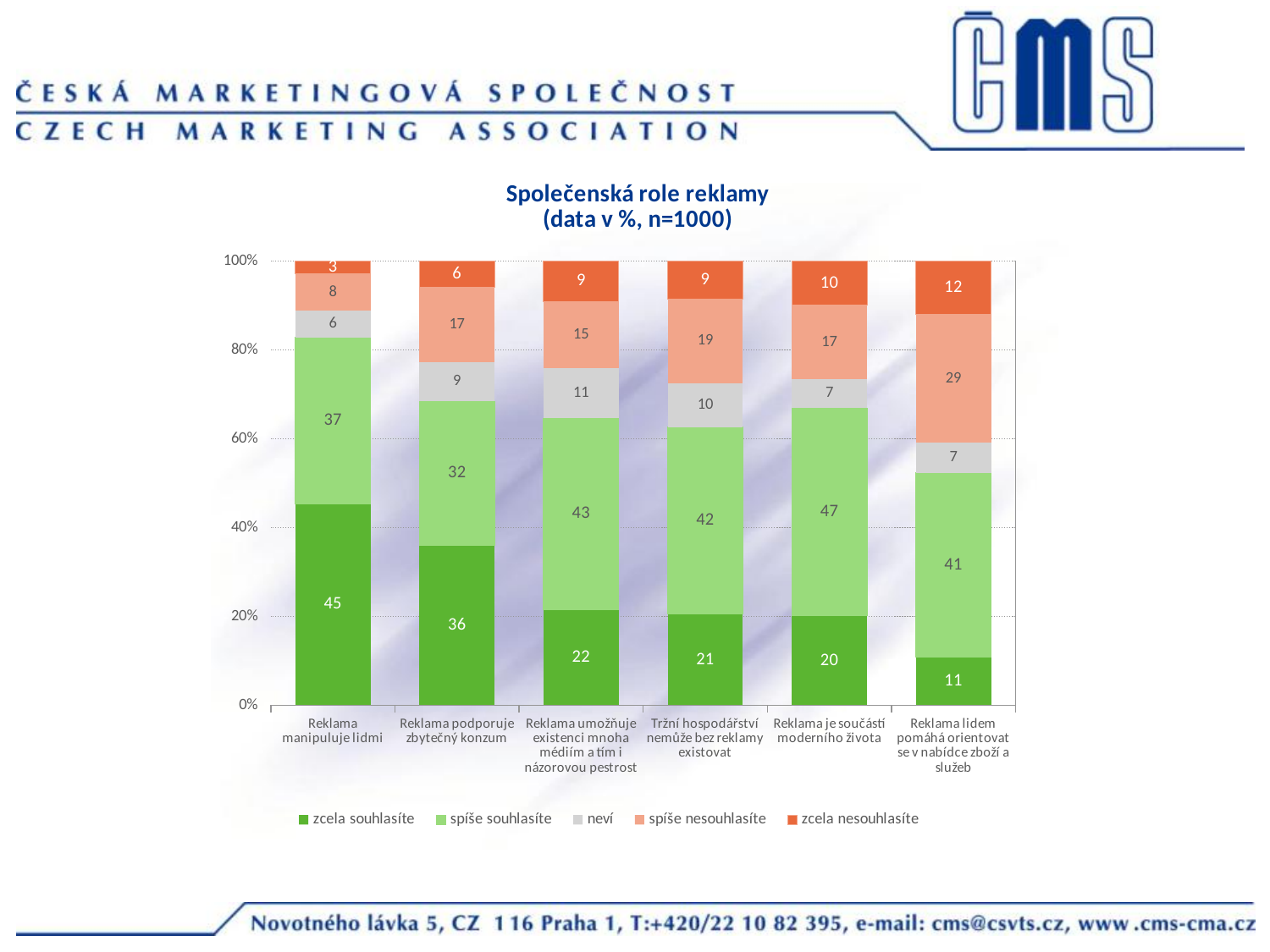
What is the value of 'zcela souhlasíte' for 'Reklama manipuluje lidmi'? 45 Which statement has the lowest 'zcela souhlasíte' value? Reklama lidem pomáhá orientovat se v nabídce zboží a služeb How many categories (statements) are shown on the x axis? 6 Which is larger: the 'zcela nesouhlasíte' value for 'Reklama lidem pomáhá orientovat se v nabídce zboží a služeb' or for 'Reklama manipuluje lidmi'? Reklama lidem pomáhá orientovat se v nabídce zboží a služeb How many series does the legend list? 5 What is the total of the stacked bar for 'Reklama podporuje zbytečný konzum'? 100 Which statement has the highest 'zcela souhlasíte' value? Reklama manipuluje lidmi What is the difference between the 'spíše souhlasíte' values for 'Reklama je součástí moderního života' and 'Reklama podporuje zbytečný konzum'? 15 What is the value of 'neví' for 'Reklama umožňuje existenci mnoha médiím a tím i názorovou pestrost'? 11 What is the value of 'spíše nesouhlasíte' for 'Reklama lidem pomáhá orientovat se v nabídce zboží a služeb'? 29 What type of chart is shown on the slide? stacked bar chart What is the title of the chart? Společenská role reklamy (data v %, n=1000)